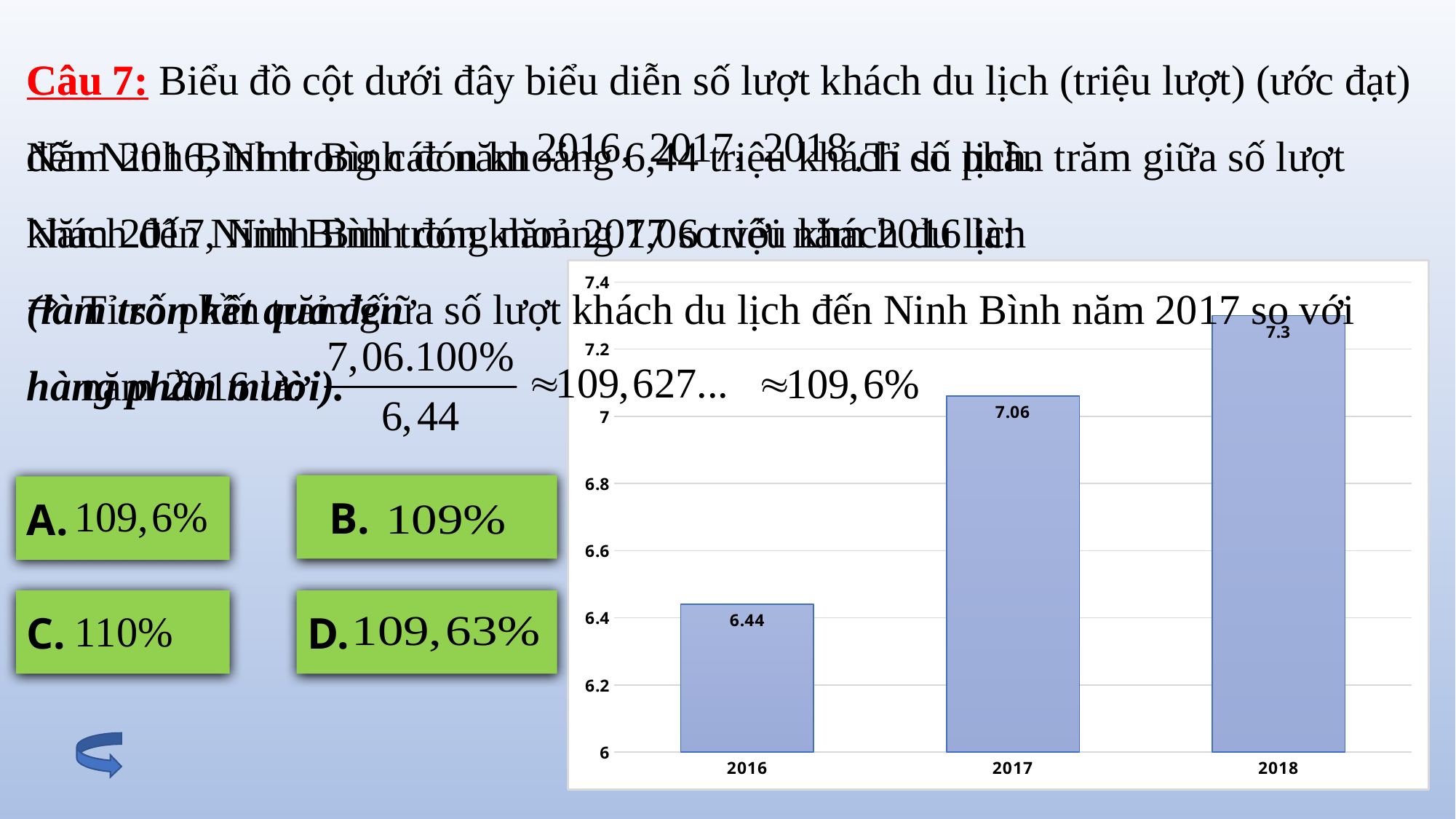
What kind of chart is shown on the slide? bar chart Do the values rise or fall from 2016 to 2018? rise What is the difference between the values for 2017 and 2016? 0.62 What is the value shown for 2017? 7.06 Is the value for 2016 greater or less than 6.6? less What is the value shown for 2016? 6.44 How many years are shown on the x axis of the chart? 3 Which year has the highest bar? 2018 Which is larger, the value for 2016 or the value for 2017? 2017 What is the value shown for 2018? 7.3 Which year has the lowest bar? 2016 What is the difference between the values for 2018 and 2017? 0.24